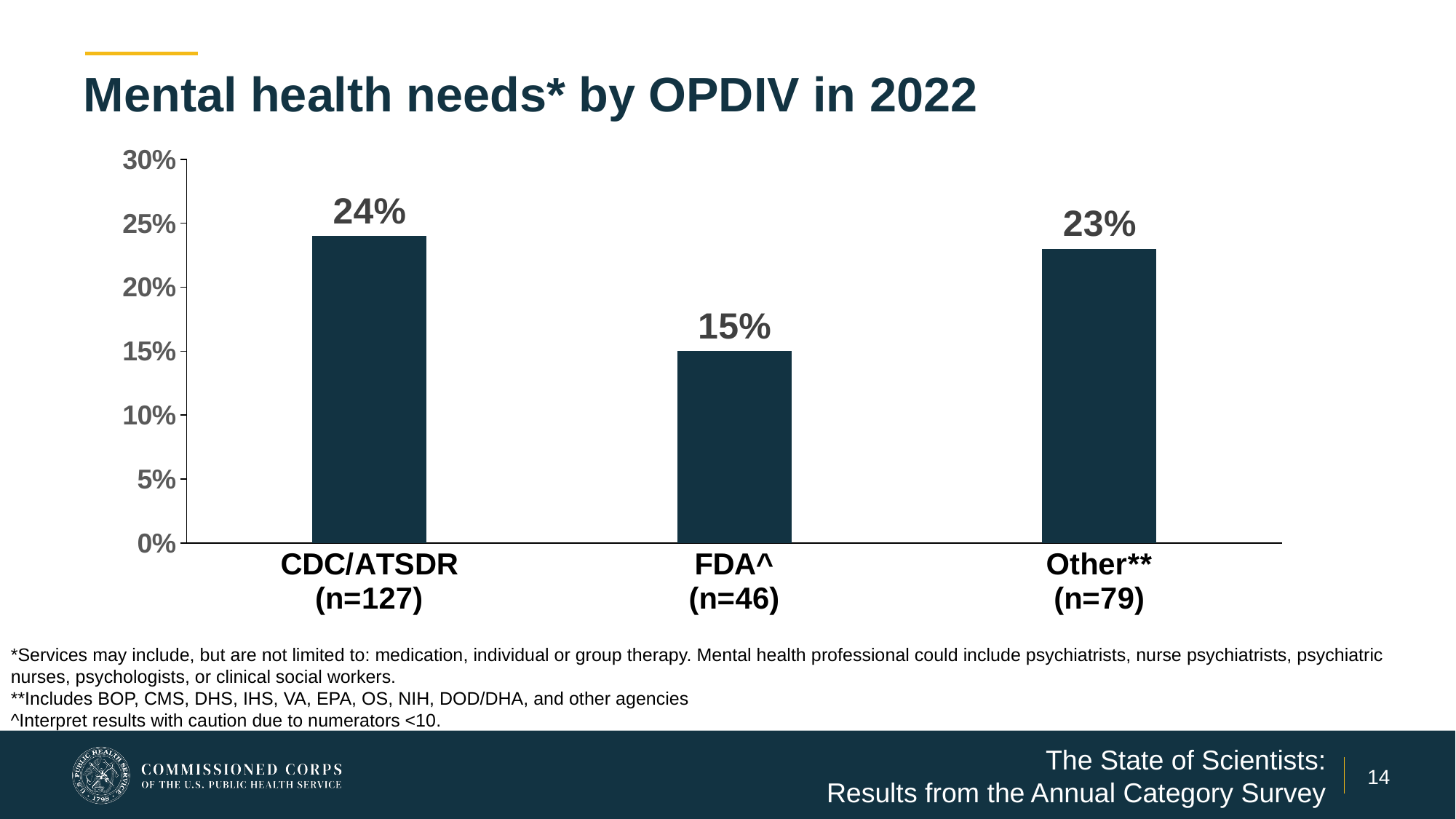
Which is larger, the value for FDA^ or the value for Other**? Other** What is the value for FDA^? 15% What kind of chart is shown on the slide? Bar chart What is the difference between the values for CDC/ATSDR and FDA^? 9% What is the title of the chart? Mental health needs* by OPDIV in 2022 What is the difference between the values for Other** and FDA^? 8% Is the value for FDA^ greater or less than 20%? less What is the value for Other**? 23% Which OPDIV has the highest value? CDC/ATSDR Which OPDIV has the lowest value? FDA^ How many OPDIV categories are shown in the chart? 3 What is the value for CDC/ATSDR? 24%